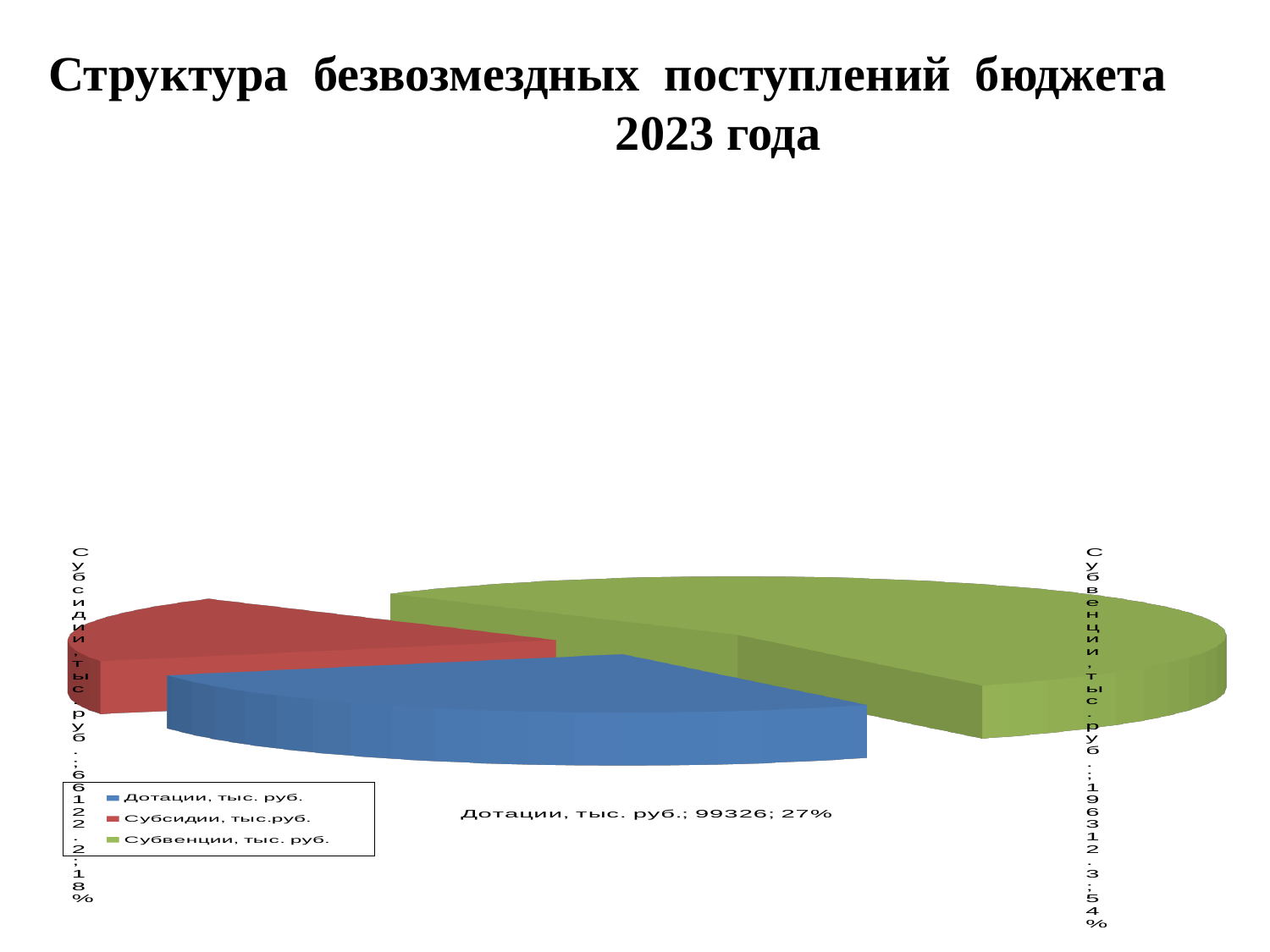
Which category has the largest slice of the pie? Субвенции, тыс. руб. Which category has the smallest slice of the pie? Субсидии, тыс. руб. What is the title of the chart on the slide? Структура безвозмездных поступлений бюджета 2023 года What share of the pie does Субвенции, тыс. руб. represent? 54% What is the value shown for Субвенции, тыс. руб.? 196312.3 What is the difference between the values for Субвенции, тыс. руб. and Дотации, тыс. руб.? 96986.3 How many entries does the legend list? 3 What is the value shown for Дотации, тыс. руб.? 99326 What share of the pie does Субсидии, тыс. руб. represent? 18% What kind of chart is shown on the slide? Pie chart How many slices does the pie chart have? 3 What is the value shown for Субсидии, тыс. руб.? 66122.2